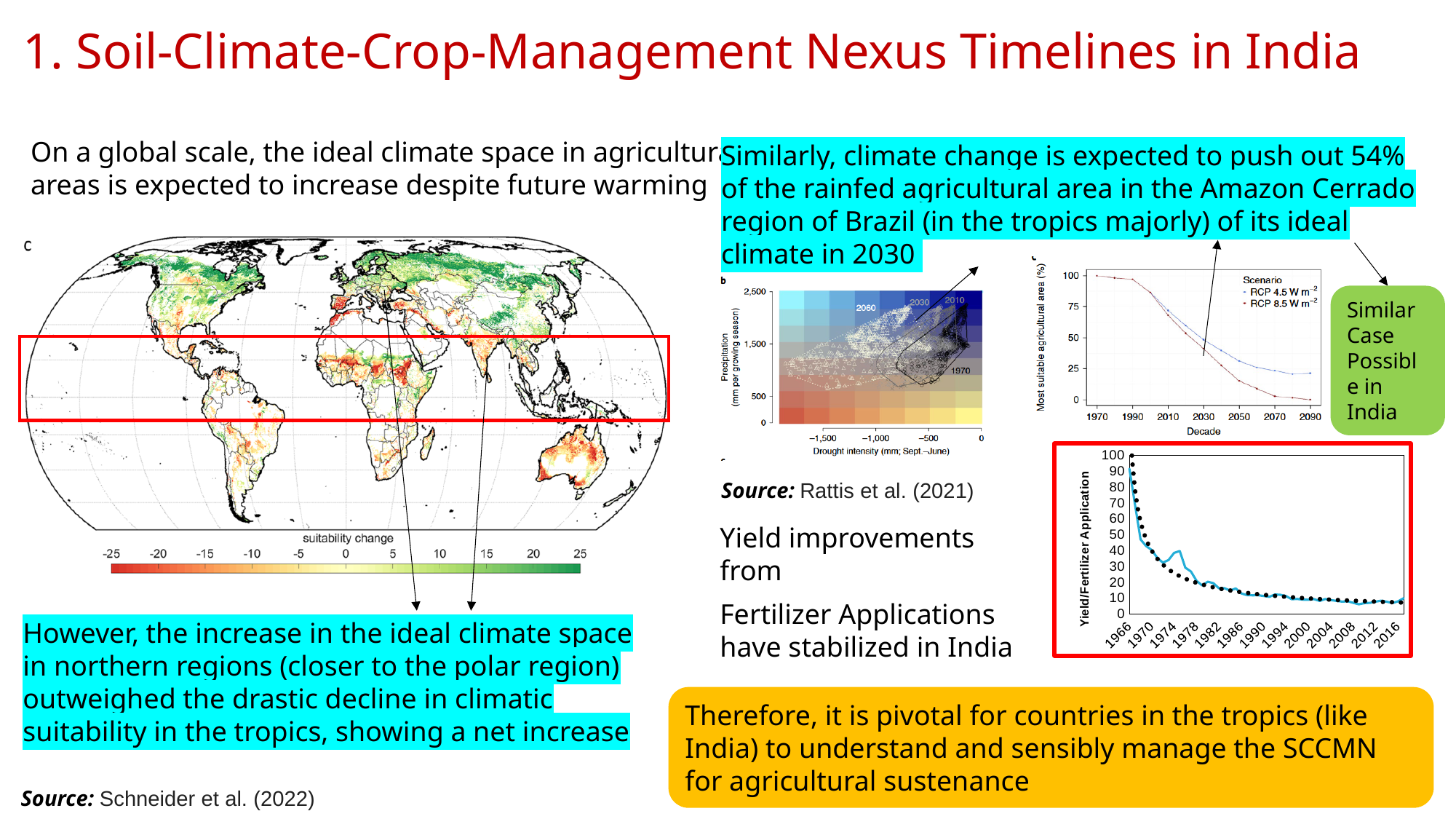
In the 'Most suitable agricultural area (%)' line chart, is the value for RCP 8.5 in 2050 greater or less than 25? less In the Yield/Fertilizer Application chart at the bottom right, is the value for 1990 greater or less than 20? less In the 'Most suitable agricultural area (%)' line chart, do the values rise or fall from 1970 to 2090? fall In the Yield/Fertilizer Application chart at the bottom right, do the values rise or fall from 1966 to 2016? fall In the 'Most suitable agricultural area (%)' line chart, which scenario has the lower value in 2090, RCP 4.5 or RCP 8.5? RCP 8.5 What kind of chart is the red-bordered chart at the bottom right showing Yield/Fertilizer Application? line chart In the Yield/Fertilizer Application chart at the bottom right, is the value for 2016 greater or less than 10? less On the world map at the left, what is the title of the colour scale below the map? suitability change In the Yield/Fertilizer Application chart at the bottom right, what is the first year shown on the x axis? 1966 In the 'Most suitable agricultural area (%)' line chart, how many scenarios does the legend list? 2